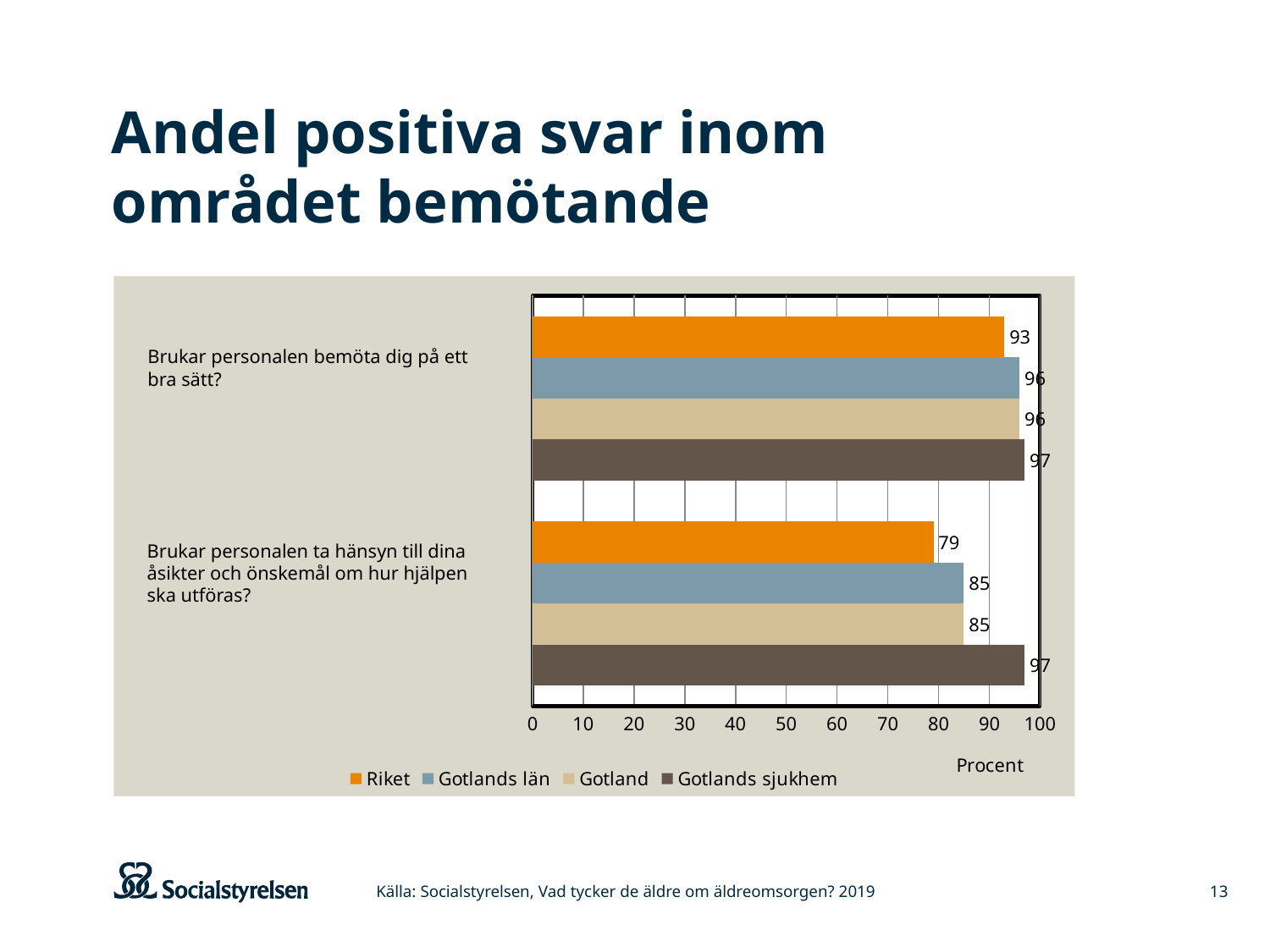
Which series has the lowest value for the question "Brukar personalen ta hänsyn till dina åsikter och önskemål om hur hjälpen ska utföras?"? Riket What kind of chart is shown on the slide? bar chart How many series does the legend list? 4 What is the value for Gotland for the question "Brukar personalen bemöta dig på ett bra sätt?"? 96 What is the value for Gotlands sjukhem for the question "Brukar personalen ta hänsyn till dina åsikter och önskemål om hur hjälpen ska utföras?"? 97 What is the label of the x axis? Procent What is the difference between the Gotlands sjukhem value and the Riket value for the question "Brukar personalen ta hänsyn till dina åsikter och önskemål om hur hjälpen ska utföras?"? 18 What is the value for Gotlands län for the question "Brukar personalen ta hänsyn till dina åsikter och önskemål om hur hjälpen ska utföras?"? 85 Which is larger for Riket: the value for "Brukar personalen bemöta dig på ett bra sätt?" or the value for "Brukar personalen ta hänsyn till dina åsikter och önskemål om hur hjälpen ska utföras?"? Brukar personalen bemöta dig på ett bra sätt? What is the value for Riket for the question "Brukar personalen bemöta dig på ett bra sätt?"? 93 Is the value for Riket for the question "Brukar personalen ta hänsyn till dina åsikter och önskemål om hur hjälpen ska utföras?" greater or less than 80? less Which series has the highest value for the question "Brukar personalen ta hänsyn till dina åsikter och önskemål om hur hjälpen ska utföras?"? Gotlands sjukhem